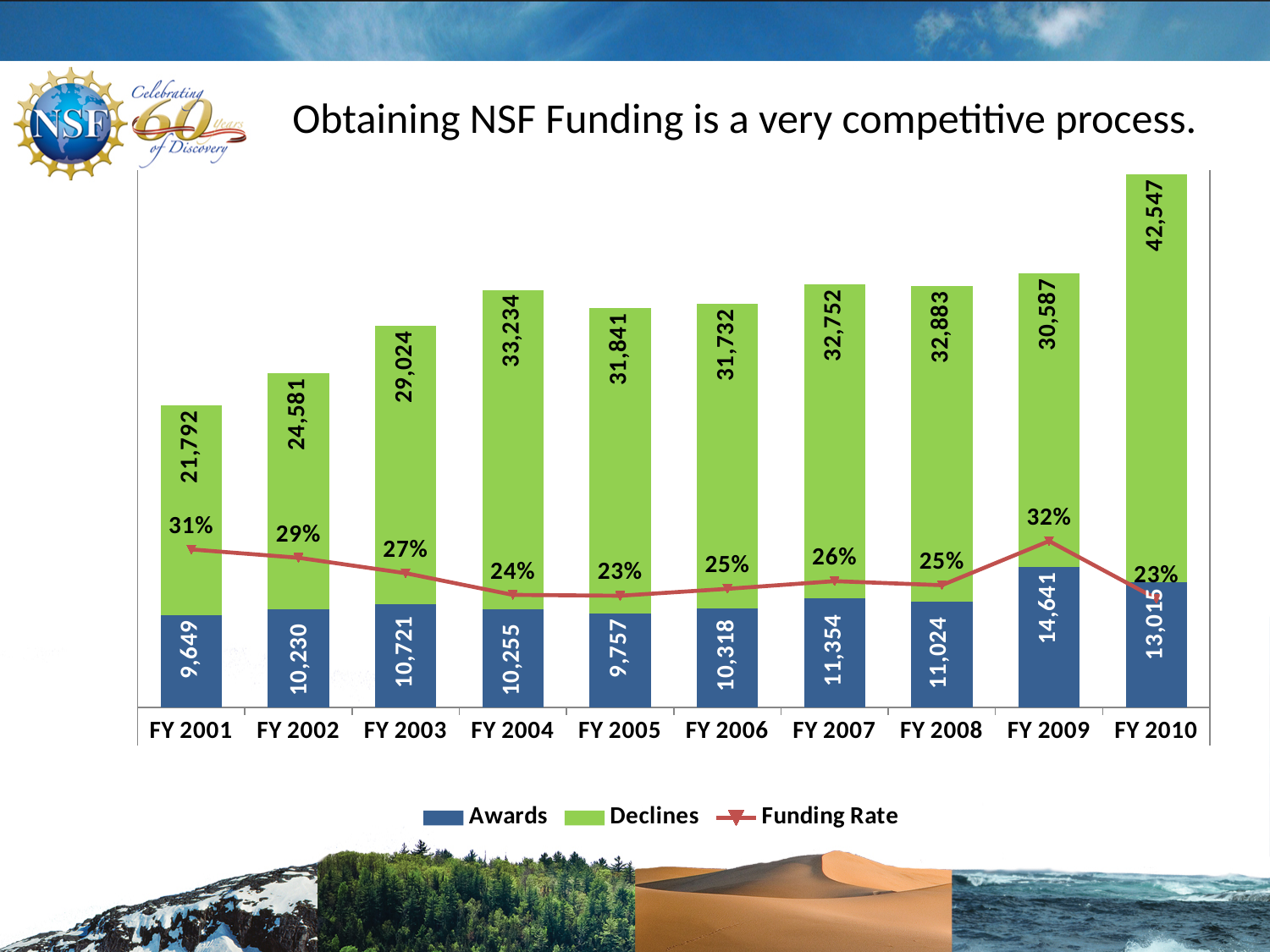
What kind of chart is shown on the slide? A combination chart with stacked bars and a line (Funding Rate) How many fiscal years are shown on the x axis? 10 What is the Funding Rate for FY 2001? 31% Which fiscal year has the highest number of Declines? FY 2010 What is the number of Declines shown for FY 2004? 33,234 Which is larger, the number of Awards in FY 2007 or in FY 2008? FY 2007 Which fiscal year has the lowest number of Awards? FY 2001 How many series does the legend list? 3 Which fiscal year has the highest Funding Rate? FY 2009 What is the total of Awards and Declines for FY 2001? 31,441 How many Awards were there in FY 2009? 14,641 What is the difference in Declines between FY 2010 and FY 2009? 11,960